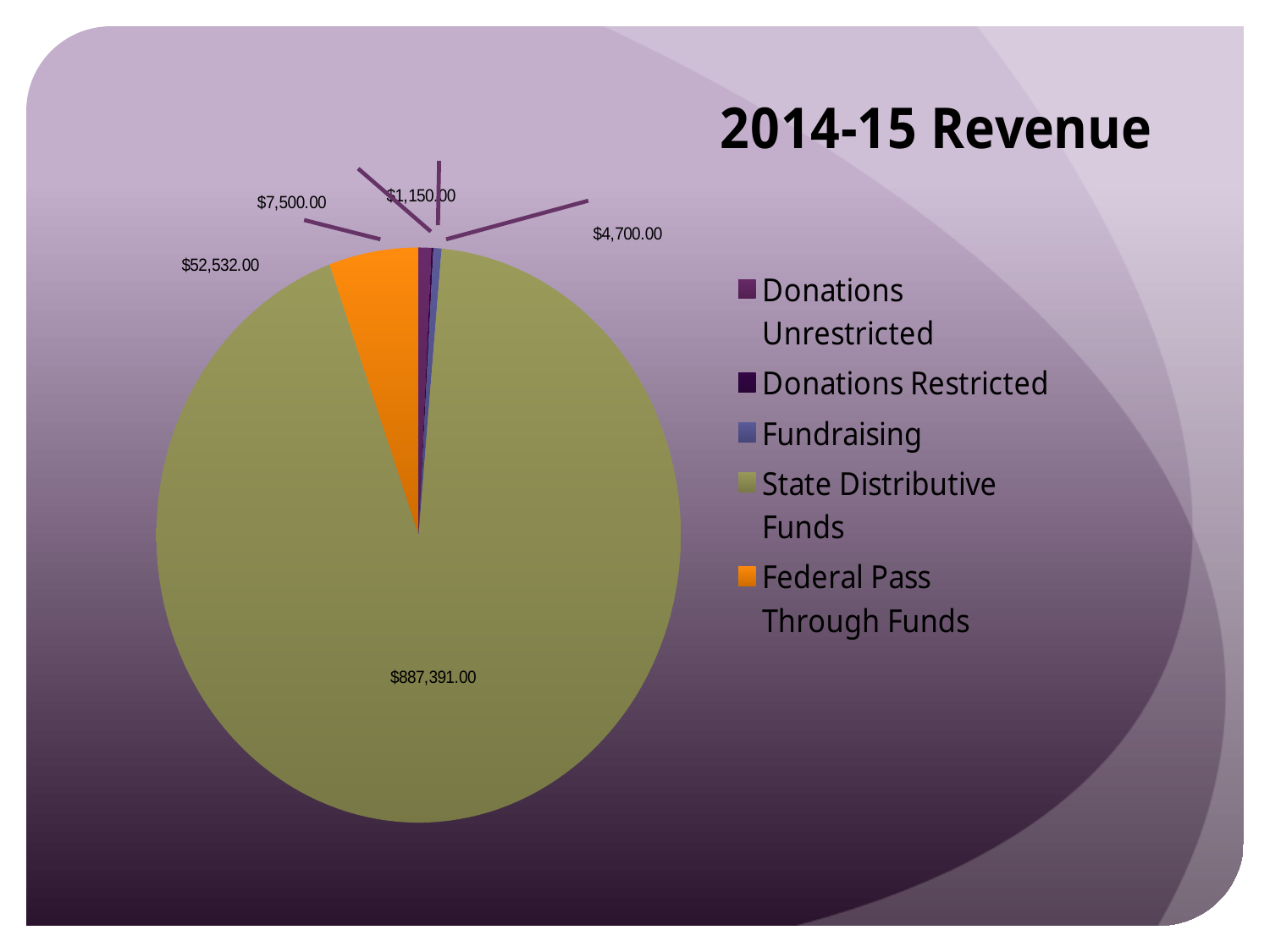
How many categories does the legend list? 5 Which category is shown in orange? Federal Pass Through Funds What is the title of the chart? 2014-15 Revenue What is the value for State Distributive Funds? $887,391.00 What type of chart is shown on the slide? Pie chart What is the value for Federal Pass Through Funds? $52,532.00 Which category is the second largest slice of the pie? Federal Pass Through Funds What is the smallest value labelled on the chart? $1,150.00 Which category has the largest slice of the pie? State Distributive Funds What is the total of all the values labelled on the chart? $953,273.00 Which is larger, State Distributive Funds or Federal Pass Through Funds? State Distributive Funds What is the difference between State Distributive Funds and Federal Pass Through Funds? $834,859.00